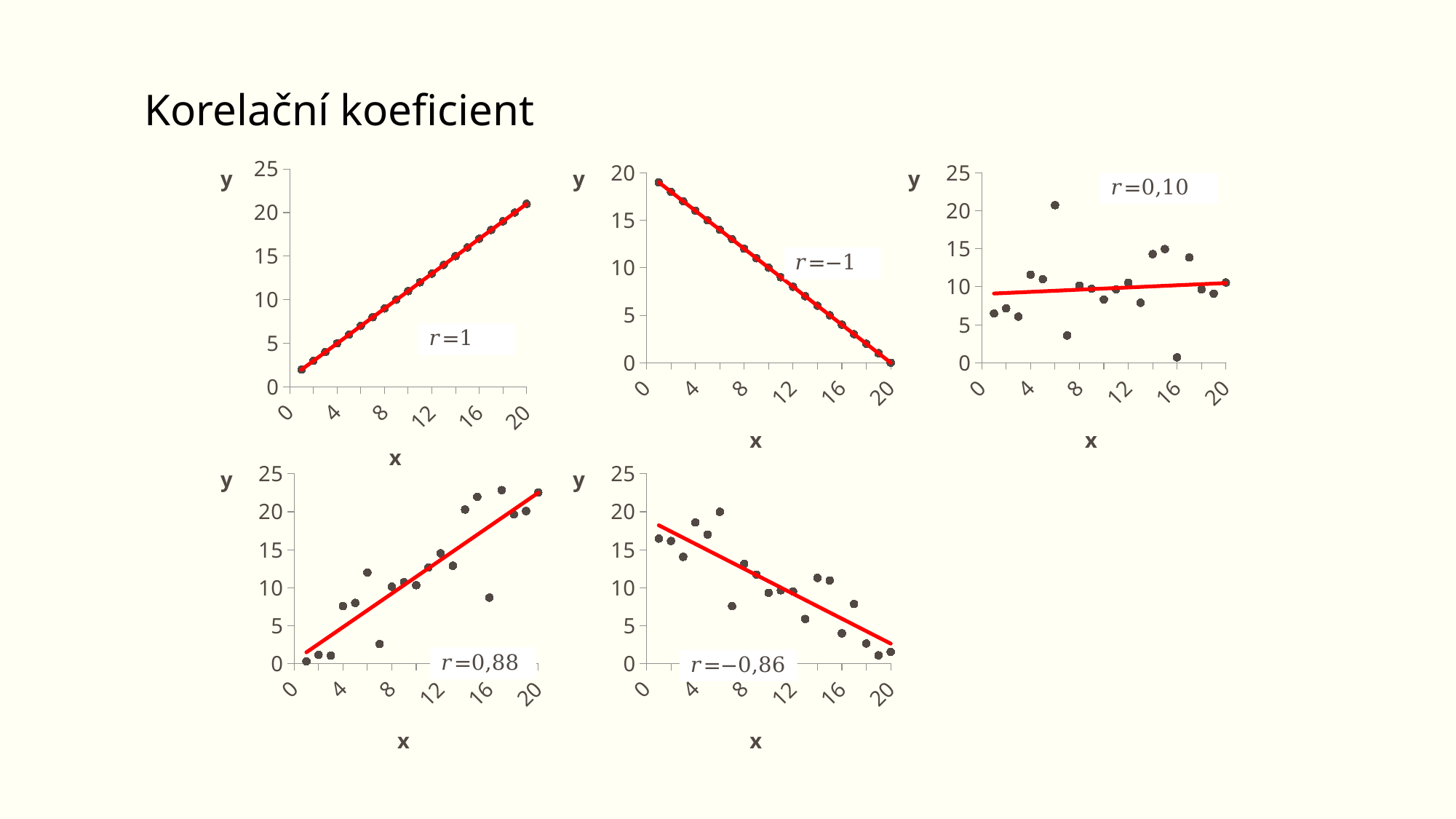
In the top-middle chart labelled r=−1, what is the y value of the point at x=20? 0 How many charts are shown on the slide? 5 In the bottom-middle chart labelled r=−0,86, do the y values generally rise or fall as x increases? fall In the top-right chart labelled r=0,10, is the y value of the point at x=16 greater or less than 5? less In the top-middle chart labelled r=−1, do the y values rise or fall as x increases? fall In the bottom-left chart labelled r=0,88, do the y values generally rise or fall as x increases? rise In the bottom-middle chart labelled r=−0,86, is the y value of the point at x=7 greater or less than 15? less What correlation coefficient is printed on the top-right chart? r=0,10 What kind of chart is the top-left chart labelled r=1? scatter chart In the top-left chart labelled r=1, which point has the larger y value, the one at x=20 or the one at x=4? x=20 What correlation coefficient is printed on the bottom-middle chart? r=−0,86